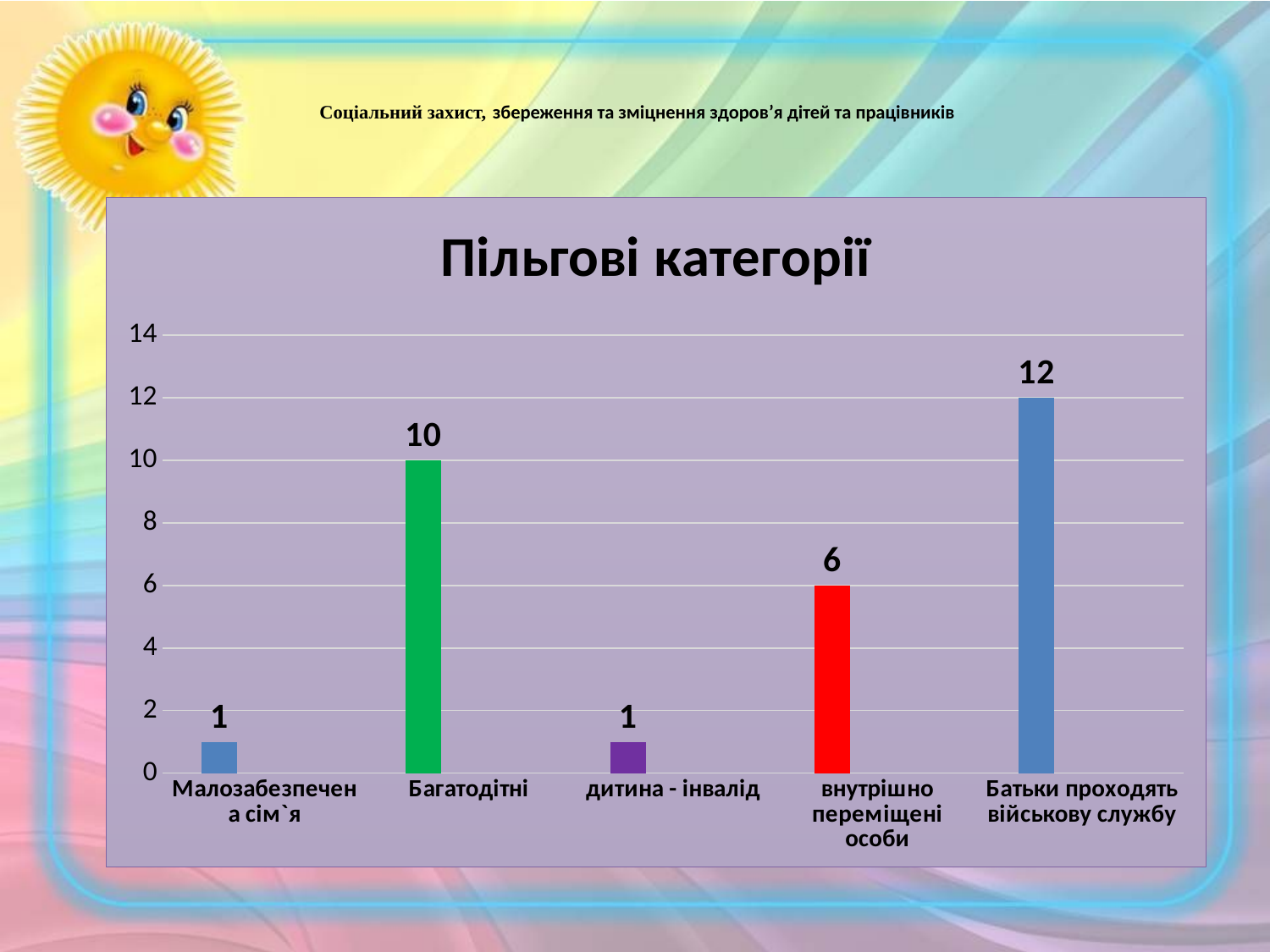
What colour is the bar for внутрішно переміщені особи? red How many categories are shown on the chart? 5 What is the value for дитина - інвалід? 1 What is the title of the chart? Пільгові категорії What is the value for Багатодітні? 10 Which category has the highest value? Батьки проходять військову службу What is the difference between the values for Багатодітні and внутрішно переміщені особи? 4 Which is larger, the value for Багатодітні or the value for внутрішно переміщені особи? Багатодітні What is the difference between the values for Батьки проходять військову службу and Багатодітні? 2 What is the value for внутрішно переміщені особи? 6 What is the value for Батьки проходять військову службу? 12 What kind of chart is shown on the slide? bar chart